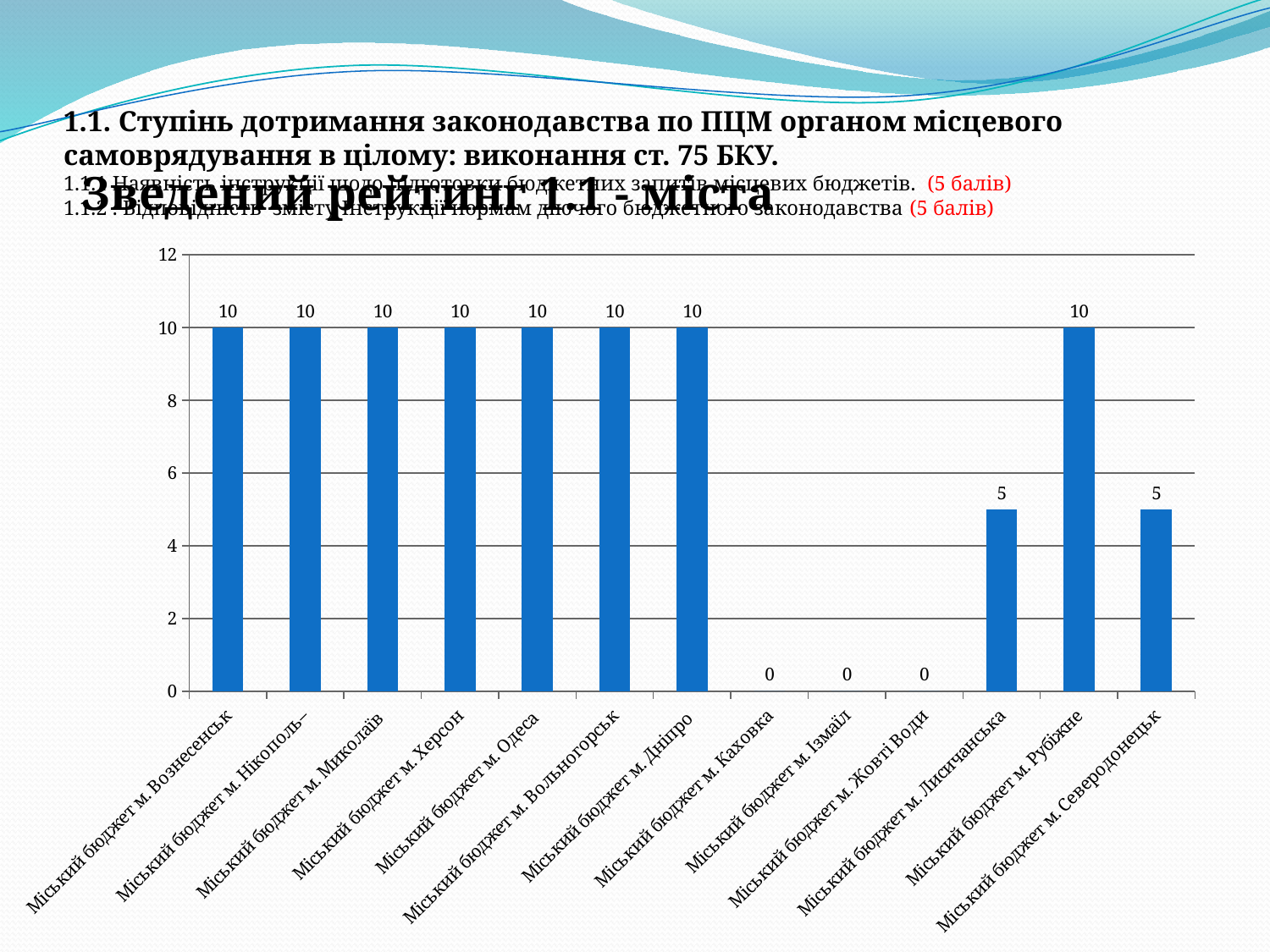
How many categories have a value of 0? 3 How many categories have a value of 10? 8 What is the difference between the values for Міський бюджет м. Рубіжне and Міський бюджет м. Северодонецьк? 5 How many categories are shown on the x axis of the chart? 13 What value is shown for Міський бюджет м. Северодонецьк? 5 Which is larger, the value for Міський бюджет м. Дніпро or the value for Міський бюджет м. Лисичанська? Міський бюджет м. Дніпро What kind of chart is shown on the slide? Bar chart What value is shown for Міський бюджет м. Лисичанська? 5 What is the maximum value shown on the vertical axis of the chart? 12 What value is shown for Міський бюджет м. Каховка? 0 Is the value for Міський бюджет м. Одеса greater or less than 8? greater What value is shown for Міський бюджет м. Херсон? 10